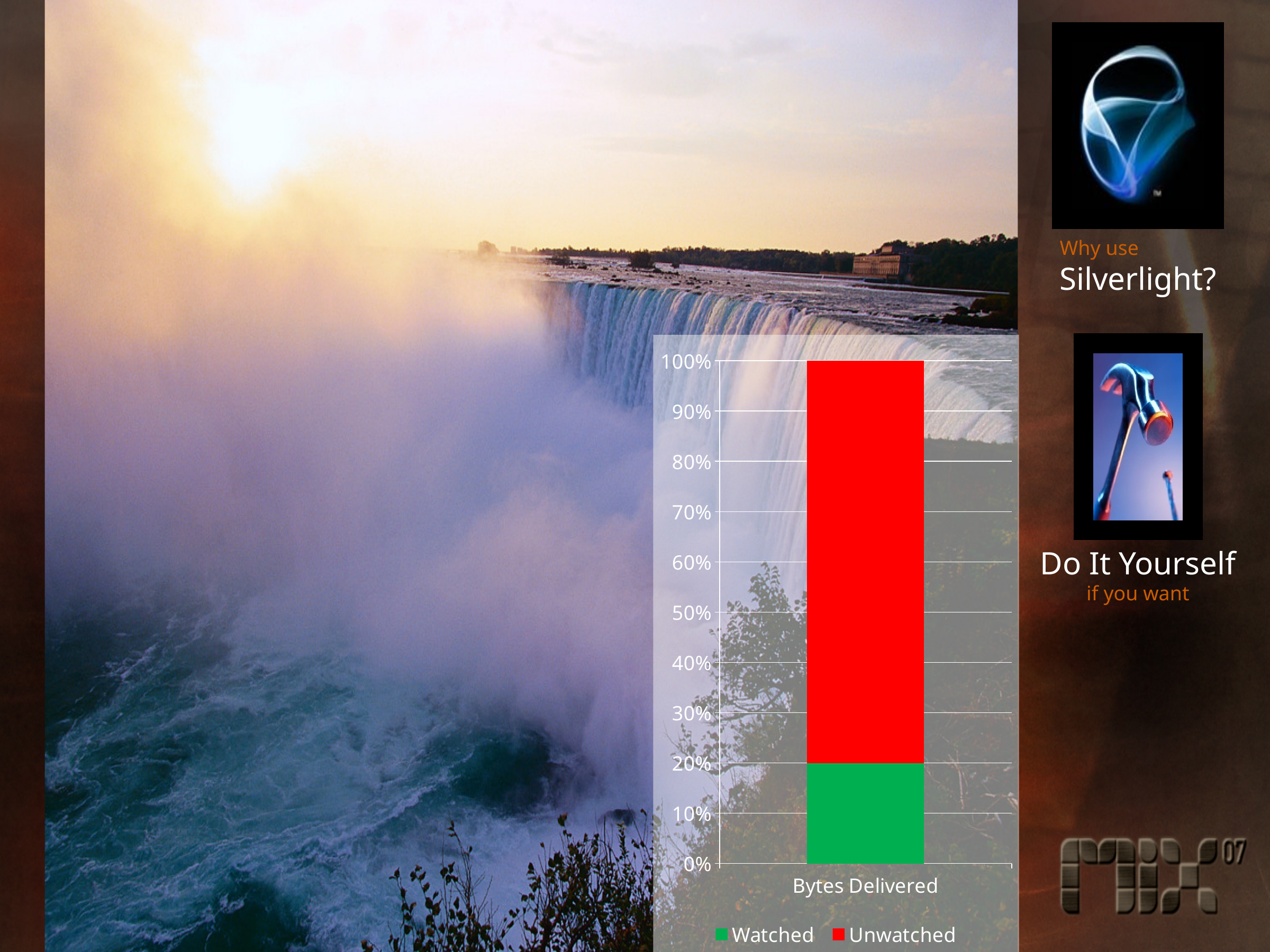
Which series is larger for Bytes Delivered, Watched or Unwatched? Unwatched Is the Unwatched share of Bytes Delivered greater or less than 50%? greater Which series is shown in green in the chart? Watched What kind of chart is shown on the slide? bar chart How many series does the chart legend list? 2 Which series has the smallest share of the Bytes Delivered bar? Watched What value on the y axis does the Watched segment of the Bytes Delivered bar reach? 20% Is the Watched share of Bytes Delivered greater or less than 50%? less What is the category label on the x axis of the chart? Bytes Delivered Is the Watched share of Bytes Delivered greater or less than 30%? less What value does the top of the stacked bar for Bytes Delivered reach on the y axis? 100% How many categories are shown on the x axis of the chart? 1